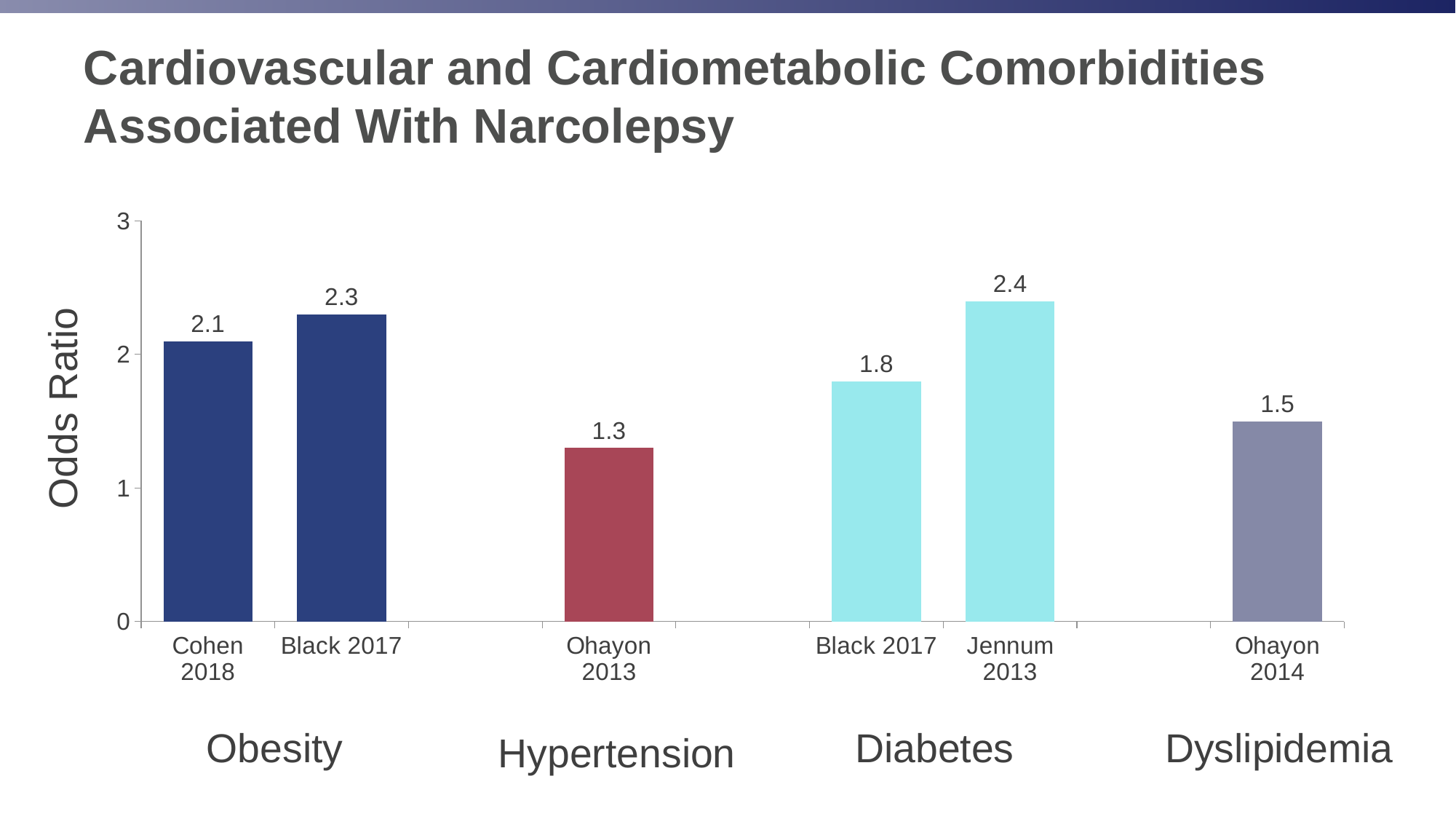
What is the odds ratio for diabetes reported by Jennum 2013? 2.4 How many bars are plotted on the chart? 6 What is the odds ratio for hypertension reported by Ohayon 2013? 1.3 Which bar has the lowest odds ratio? Ohayon 2013 (Hypertension) What is the label of the vertical axis? Odds Ratio What kind of chart is shown on the slide? Bar chart What is the odds ratio for obesity reported by Cohen 2018? 2.1 What is the difference between the Jennum 2013 and Black 2017 odds ratios for diabetes? 0.6 What is the difference between the two obesity odds ratios (Black 2017 and Cohen 2018)? 0.2 Which bar has the highest odds ratio? Jennum 2013 (Diabetes) What is the odds ratio for dyslipidemia reported by Ohayon 2014? 1.5 Which is larger: the odds ratio for obesity from Black 2017 or the odds ratio for diabetes from Black 2017? Obesity (Black 2017)